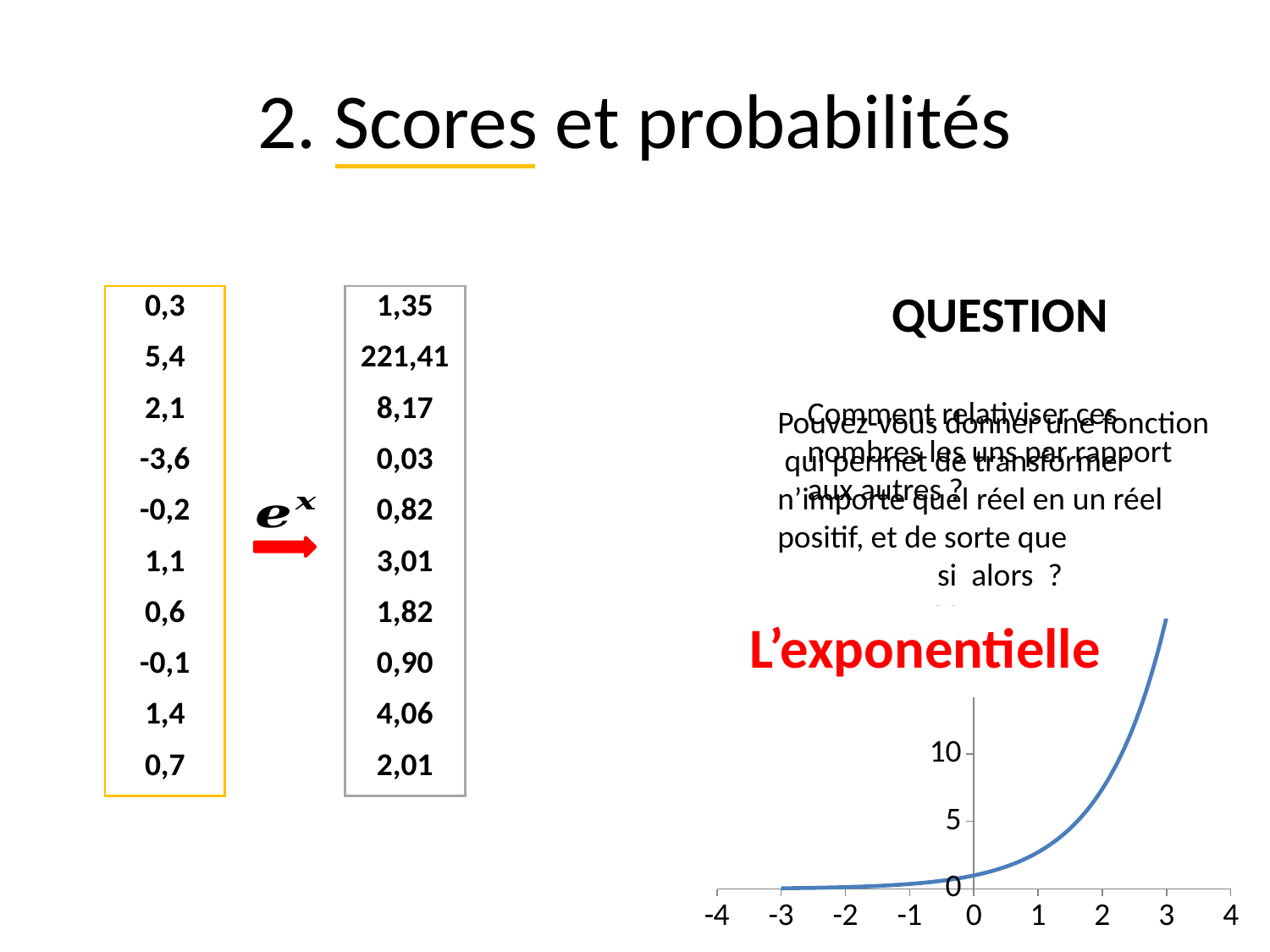
What is the highest tick label shown on the y axis of the chart? 10 What colour is the curve plotted on the chart? blue How many tick labels are shown on the x axis of the chart? 9 What kind of chart is shown at the bottom right of the slide? line chart At which x value shown on the chart does the curve reach its lowest point? -3 Is the value of the curve at x = 2 greater or less than 5? greater Is the value of the curve at x = -2 greater or less than 5? less Is the value of the curve at x = 1 greater or less than 5? less Do the values on the chart rise or fall as x increases from -3 to 3? rise At which x value shown on the chart does the curve reach its highest point? 3 Which is larger on the chart: the value at x = 2 or the value at x = -2? x = 2